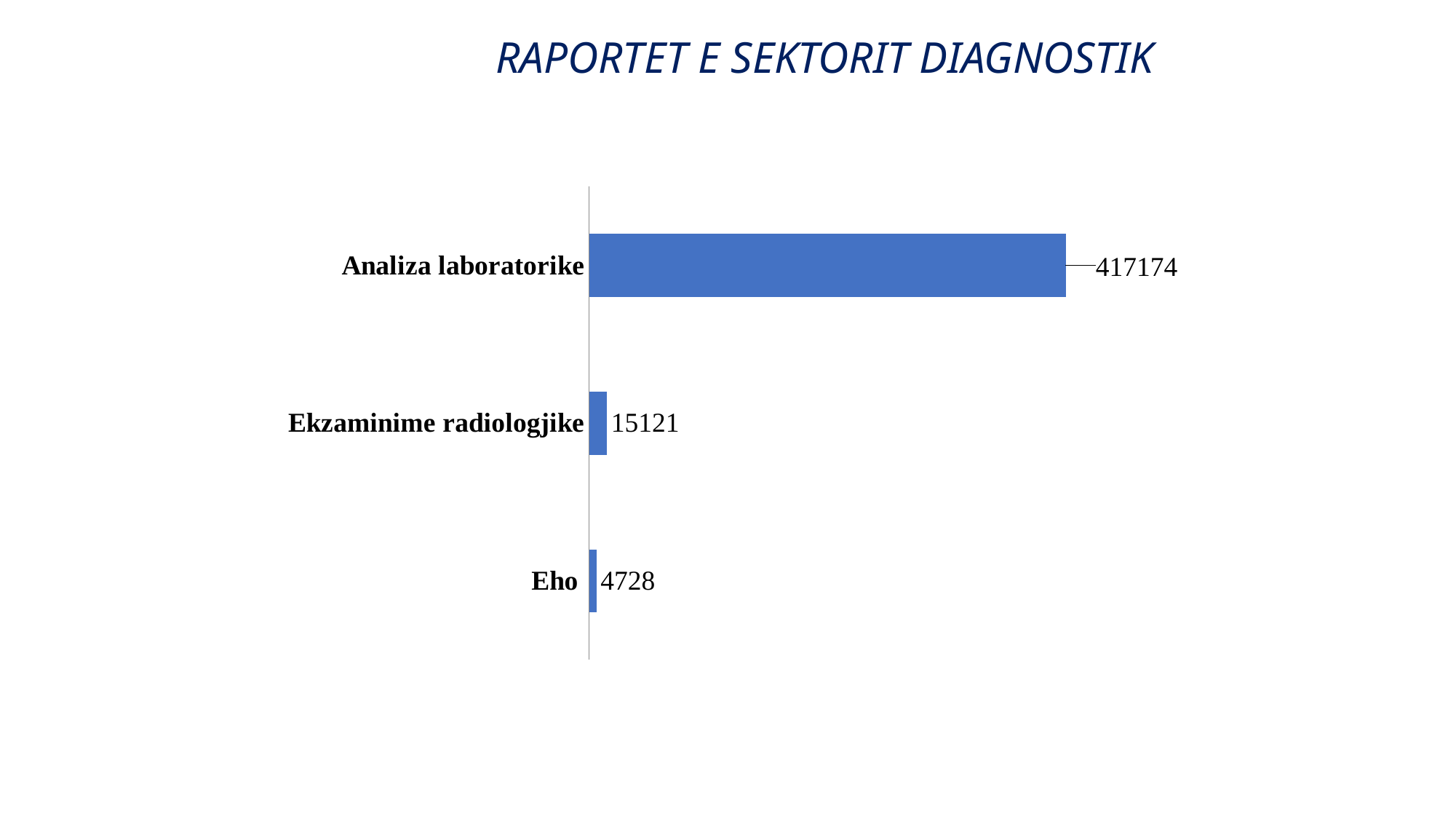
What is the value for Analiza laboratorike? 417174 What is the value for Eho? 4728 Which category has the highest value? Analiza laboratorike What is the difference between the values for Ekzaminime radiologjike and Eho? 10393 What is the difference between the values for Analiza laboratorike and Ekzaminime radiologjike? 402053 What kind of chart is shown on the slide? Bar chart Which category has the lowest value? Eho What is the title of the slide? RAPORTET E SEKTORIT DIAGNOSTIK How many categories are shown in the chart? 3 Which is larger, the value for Ekzaminime radiologjike or the value for Eho? Ekzaminime radiologjike What colour are the bars in the chart? Blue What is the value for Ekzaminime radiologjike? 15121